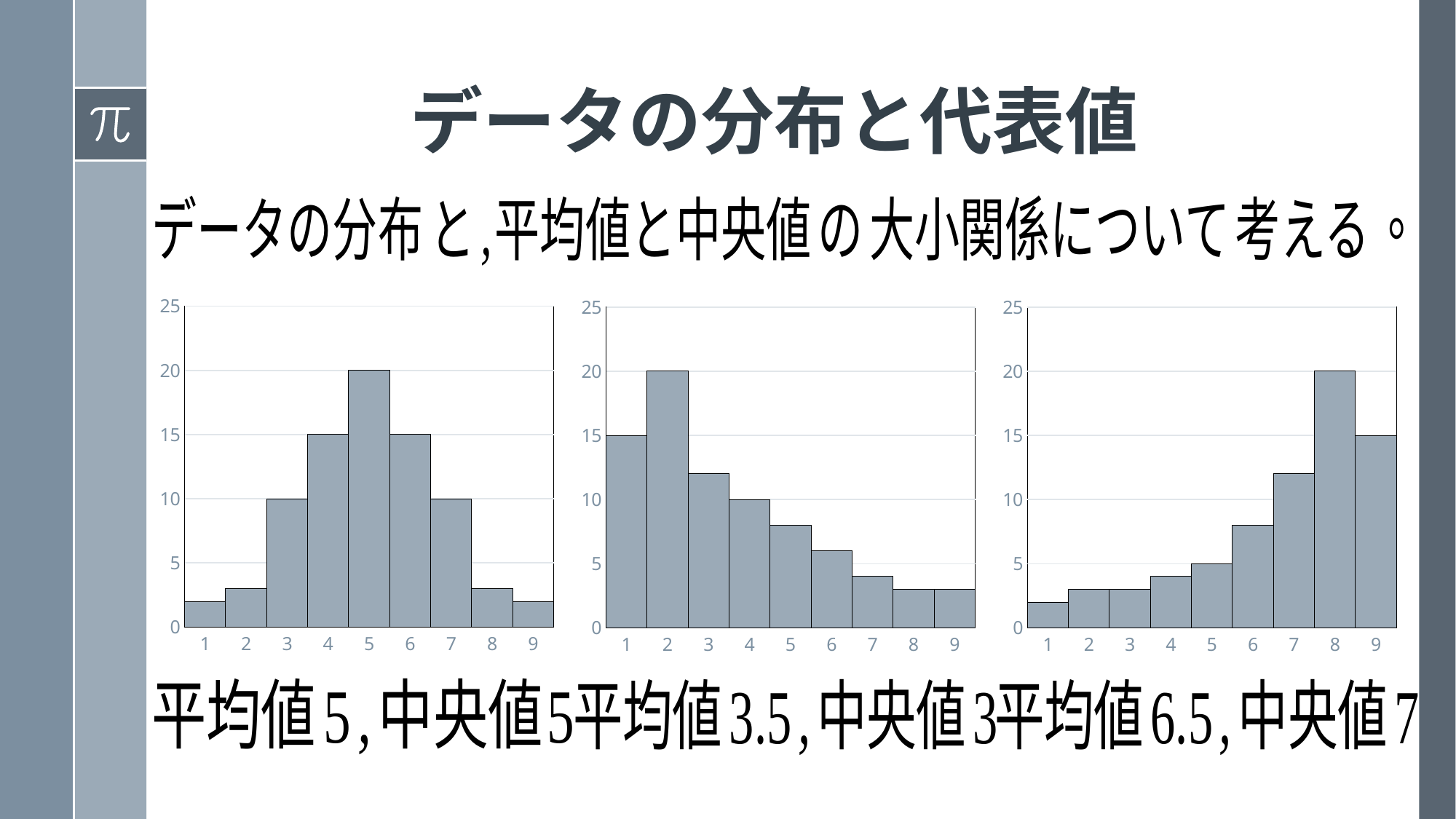
In the middle chart, do the values generally rise or fall from category 2 to category 9? fall In the middle chart, which category has the highest bar? 2 In the left chart, how many categories are shown on the x axis? 9 In the right chart, which category has the highest bar? 8 In the right chart, what is the difference between the values for category 8 and category 9? 5 In the left chart, what is the value for category 5? 20 What kind of chart is the left chart? bar chart In the middle chart, what is the value for category 1? 15 In the left chart, is the value for category 2 greater or less than 5? less In the left chart, what is the difference between the values for category 5 and category 4? 5 In the middle chart, which is larger, the value for category 3 or the value for category 7? category 3 In the left chart, which category has the highest bar? 5